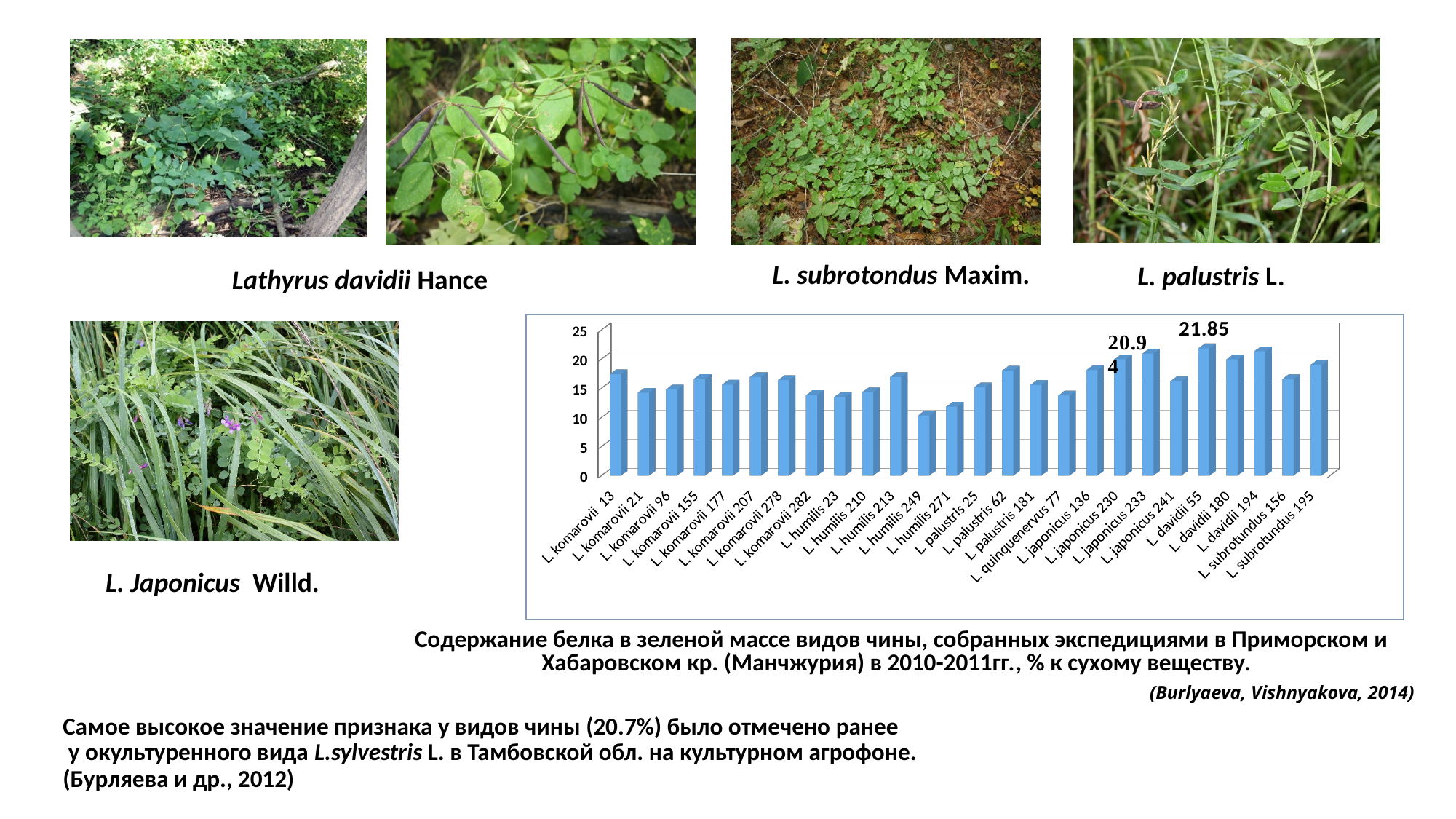
How many categories (samples) are plotted on the x axis? 26 Is the value for L. komarovii 13 greater or less than 15? greater Which category has the lowest value? L. humilis 249 Which category has the highest value? L. davidii 55 Is the value for L. humilis 271 greater or less than 15? less What is the highest value shown on the vertical axis? 25 What kind of chart is shown on the slide? bar chart Which is larger, the value for L. davidii 55 or the value for L. humilis 249? L. davidii 55 What is the value for L. davidii 55? 21.85 Is the value for L. humilis 249 greater or less than 15? less